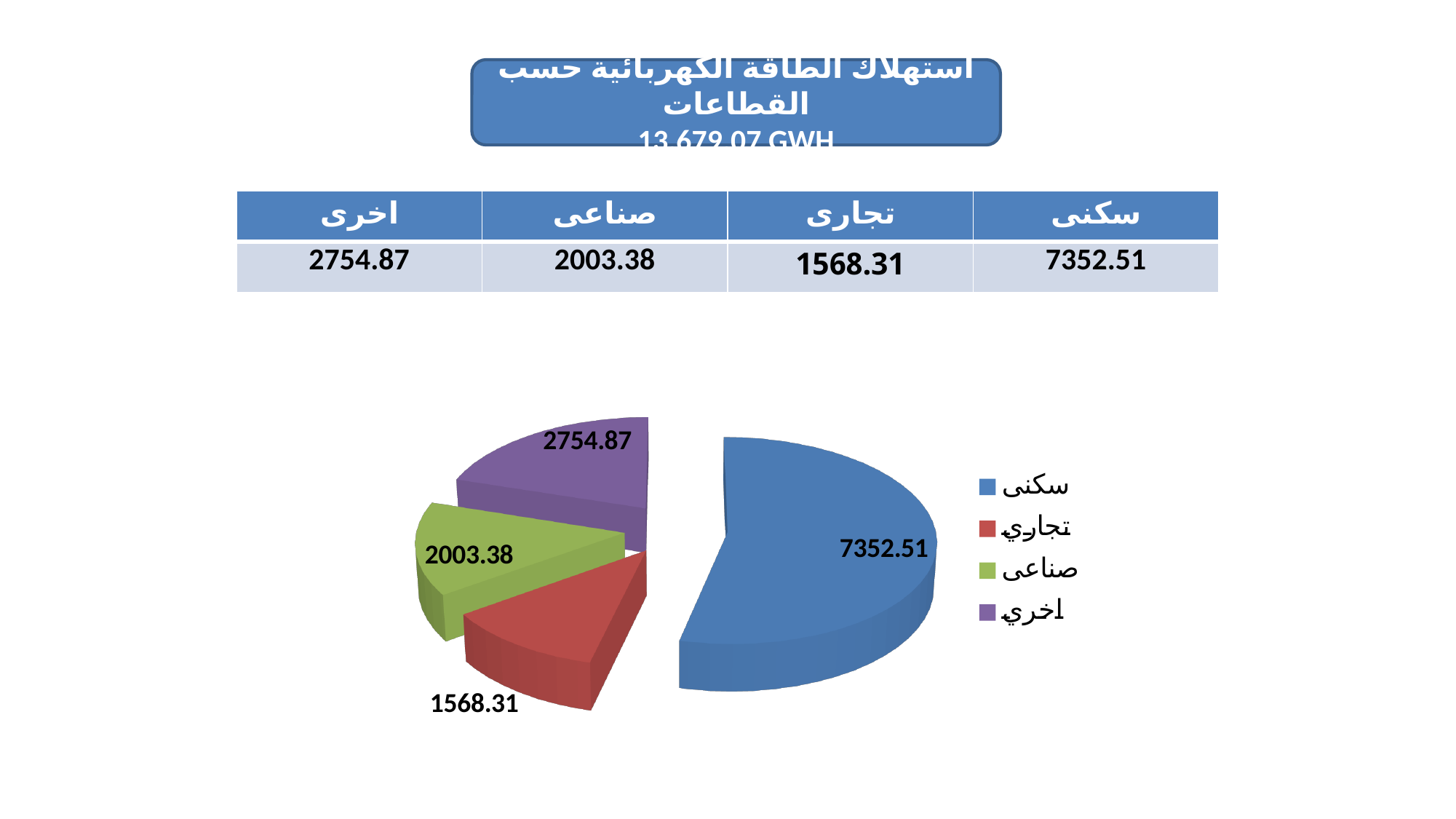
Which sector has the smallest slice in the pie chart? تجاري What is the value shown for the سكني (residential) slice of the pie chart? 7352.51 What type of chart is shown on the slide? Pie chart How many slices does the pie chart have? 4 What is the value shown for the تجاري (commercial) slice of the pie chart? 1568.31 Which is larger in the pie chart, the صناعي slice or the أخرى slice? أخرى Which sector has the largest slice in the pie chart? سكني What colour is the سكني slice in the pie chart? Blue What is the value shown for the صناعي (industrial) slice of the pie chart? 2003.38 What is the difference between the أخرى value and the صناعي value in the pie chart? 751.49 What is the difference between the سكني value and the تجاري value in the pie chart? 5784.20 What is the value shown for the أخرى (other) slice of the pie chart? 2754.87